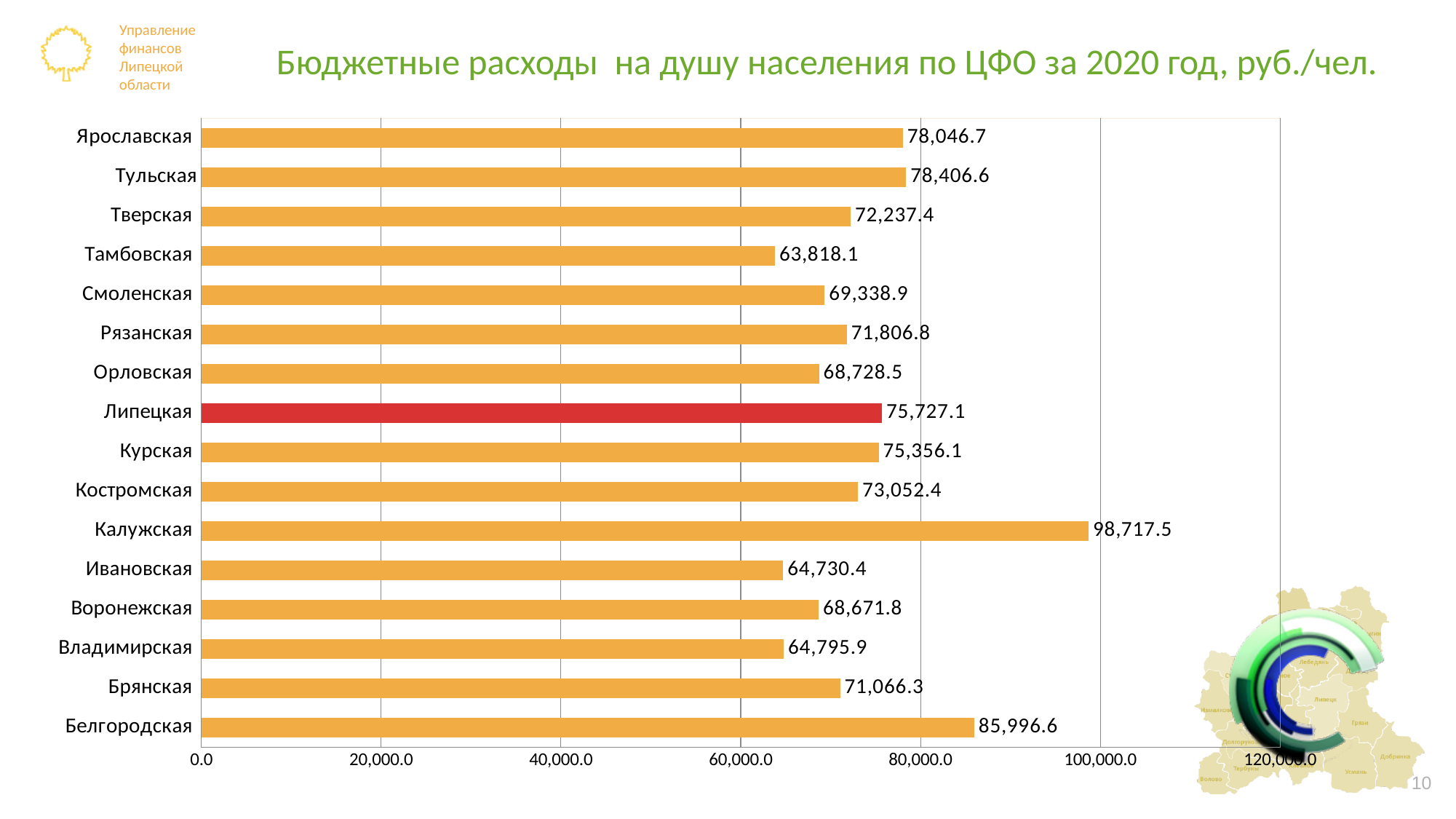
Is the value for Белгородская greater or less than 80,000.0? greater What is the difference between the values for Калужская and Белгородская? 12,720.9 Which region has the lowest value? Тамбовская What is the value for Калужская? 98,717.5 What is the value for Тамбовская? 63,818.1 What kind of chart is shown on the slide? bar chart How many regions are shown in the chart? 16 Which region has the highest value? Калужская What is the value for Липецкая? 75,727.1 Which region's bar is coloured red instead of orange? Липецкая Which is larger, the value for Белгородская or the value for Тульская? Белгородская What is the value for Белгородская? 85,996.6